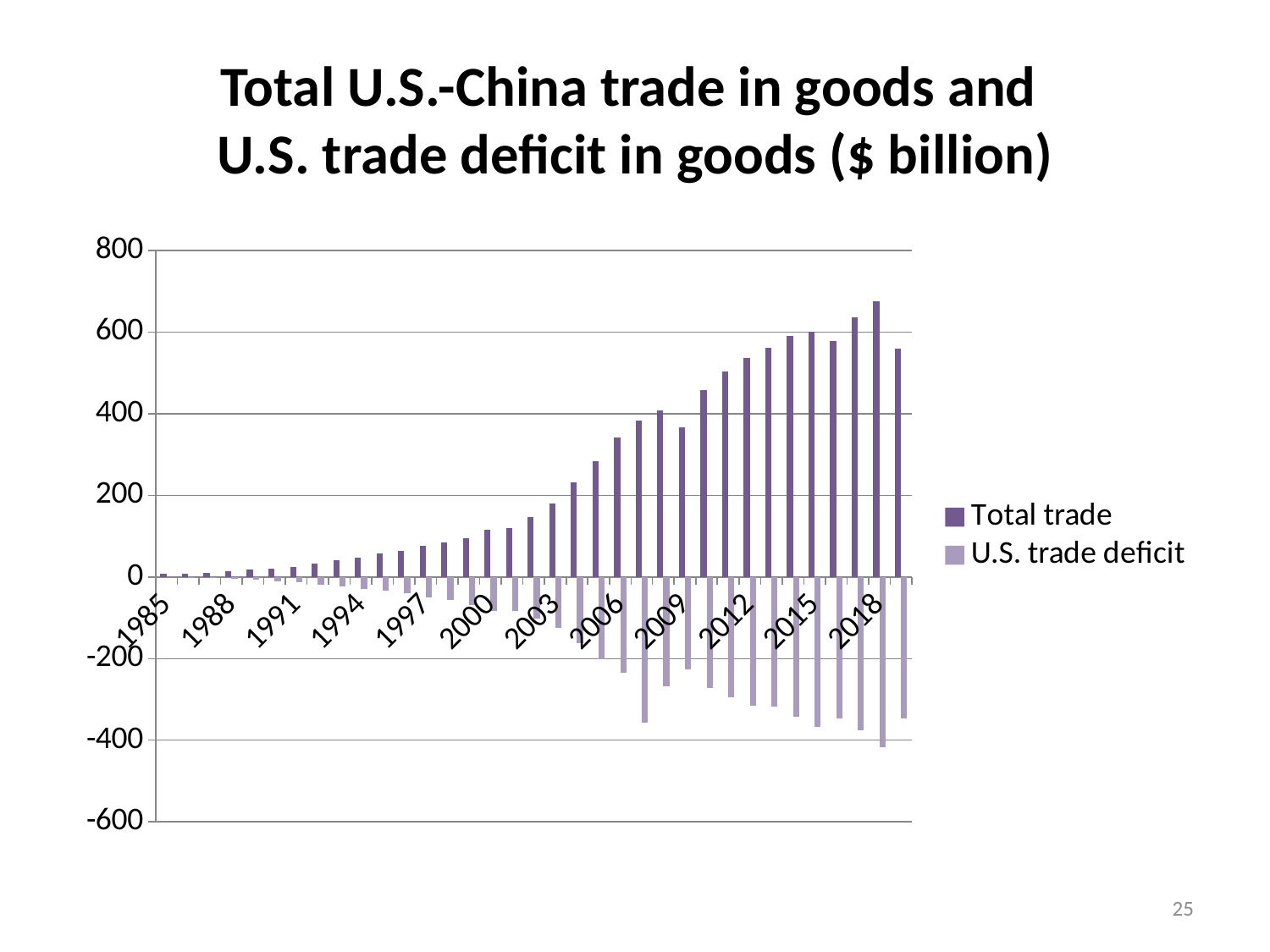
What is the title of the chart? Total U.S.-China trade in goods and U.S. trade deficit in goods ($ billion) Does Total trade generally rise or fall from 1985 to 2018? rise What kind of chart is shown on the slide? bar chart In which year is Total trade highest? 2018 Is the U.S. trade deficit value for 2018 greater or less than -400? less Is the Total trade value for 2009 greater or less than 400? less Which year has the larger Total trade value, 2012 or 2018? 2018 In which year is the U.S. trade deficit bar the lowest (most negative)? 2018 What are the two series named in the legend? Total trade and U.S. trade deficit How many series does the legend list? 2 Is the Total trade value for 2018 greater or less than 600? greater